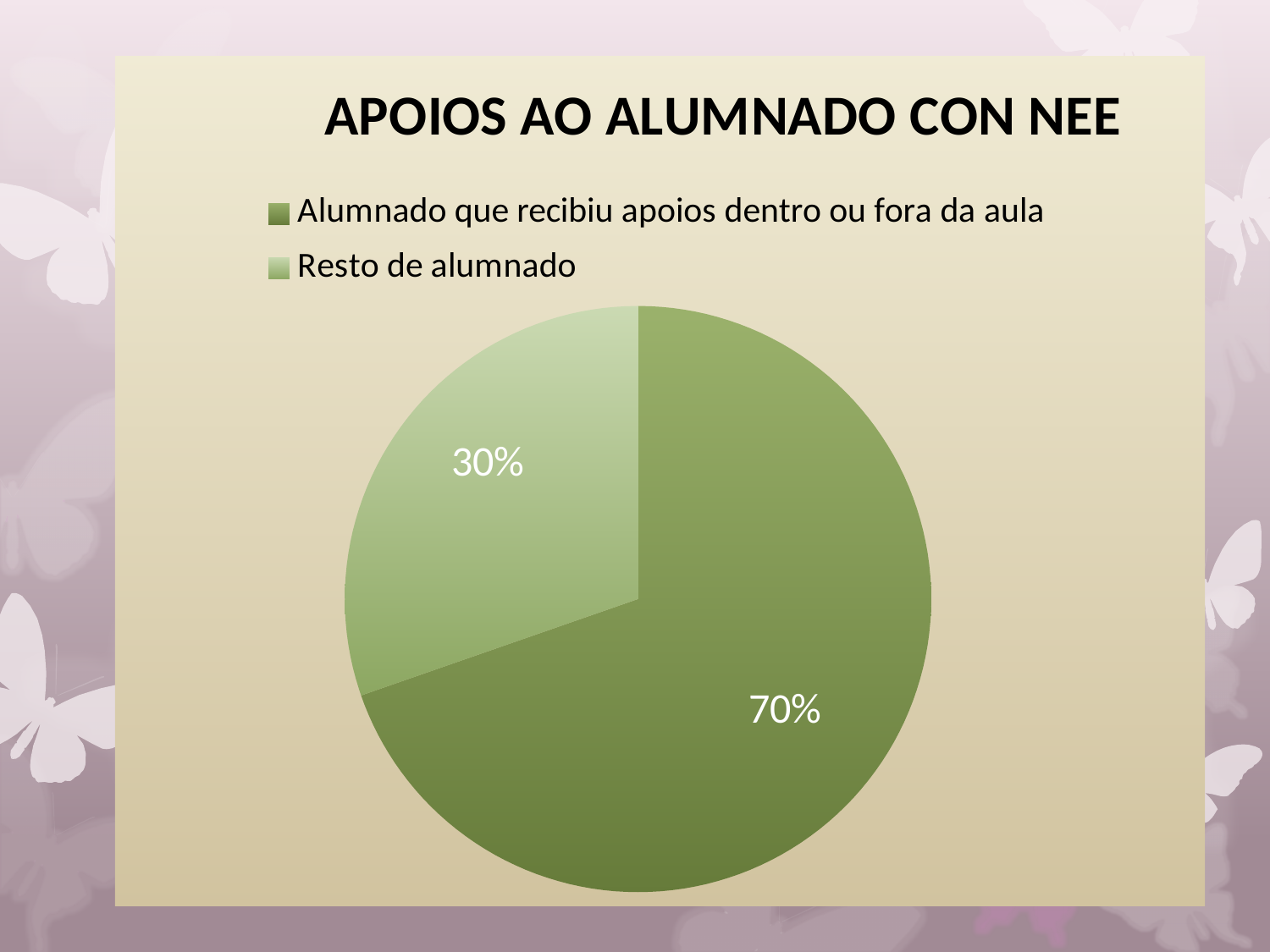
How many slices does the pie chart have? 2 What is the difference in percentage points between the "Alumnado que recibiu apoios dentro ou fora da aula" slice and the "Resto de alumnado" slice? 40 percentage points Which slice of the pie is the smallest? Resto de alumnado What share of the pie is labelled "Resto de alumnado"? 30% Which is larger: the "Resto de alumnado" slice or the "Alumnado que recibiu apoios dentro ou fora da aula" slice? Alumnado que recibiu apoios dentro ou fora da aula How many entries does the legend list? 2 What is the title of the chart? APOIOS AO ALUMNADO CON NEE Which legend entry is shown in the lighter green colour? Resto de alumnado Which slice of the pie is the largest? Alumnado que recibiu apoios dentro ou fora da aula What kind of chart is shown on the slide? pie chart What is the combined share of the two slices in the pie chart? 100% What share of the pie is labelled "Alumnado que recibiu apoios dentro ou fora da aula"? 70%